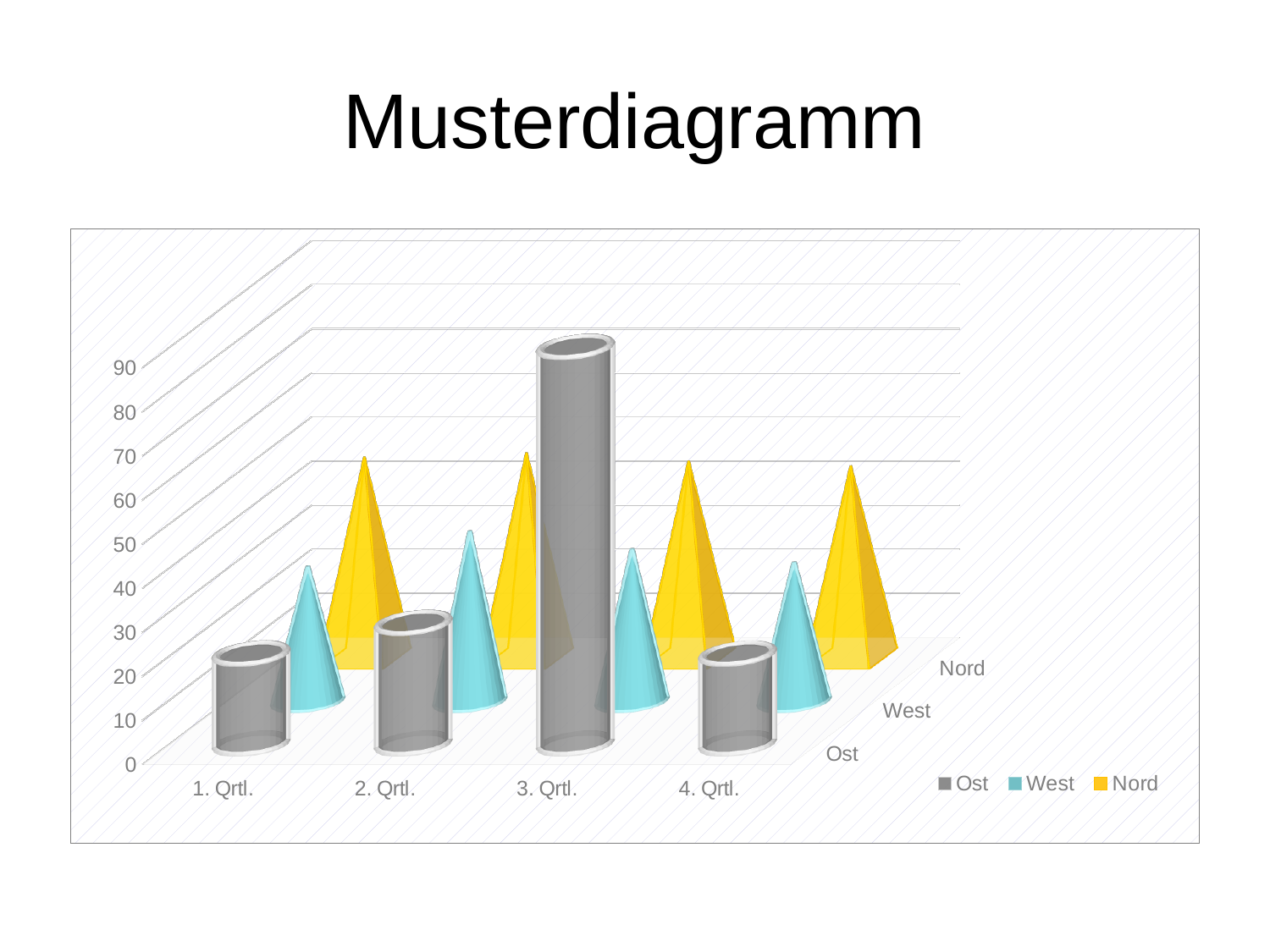
Is the value for Ost in 3. Qrtl. greater or less than 50? greater What kind of chart is shown on the slide? bar chart How many categories are shown on the x axis? 4 Which is larger: the value for Ost in 2. Qrtl. or the value for Ost in 4. Qrtl.? 2. Qrtl. Which series are listed in the legend? Ost, West, Nord How many series does the legend list? 3 Which is larger: the value for Ost in 3. Qrtl. or the value for Ost in 1. Qrtl.? 3. Qrtl. Is the value for Ost in 1. Qrtl. greater or less than 50? less In which quarter is the value for Ost highest? 3. Qrtl. What is the title of the slide's chart? Musterdiagramm Is the value for Ost in 4. Qrtl. greater or less than 40? less In which quarter is the value for West highest? 2. Qrtl.